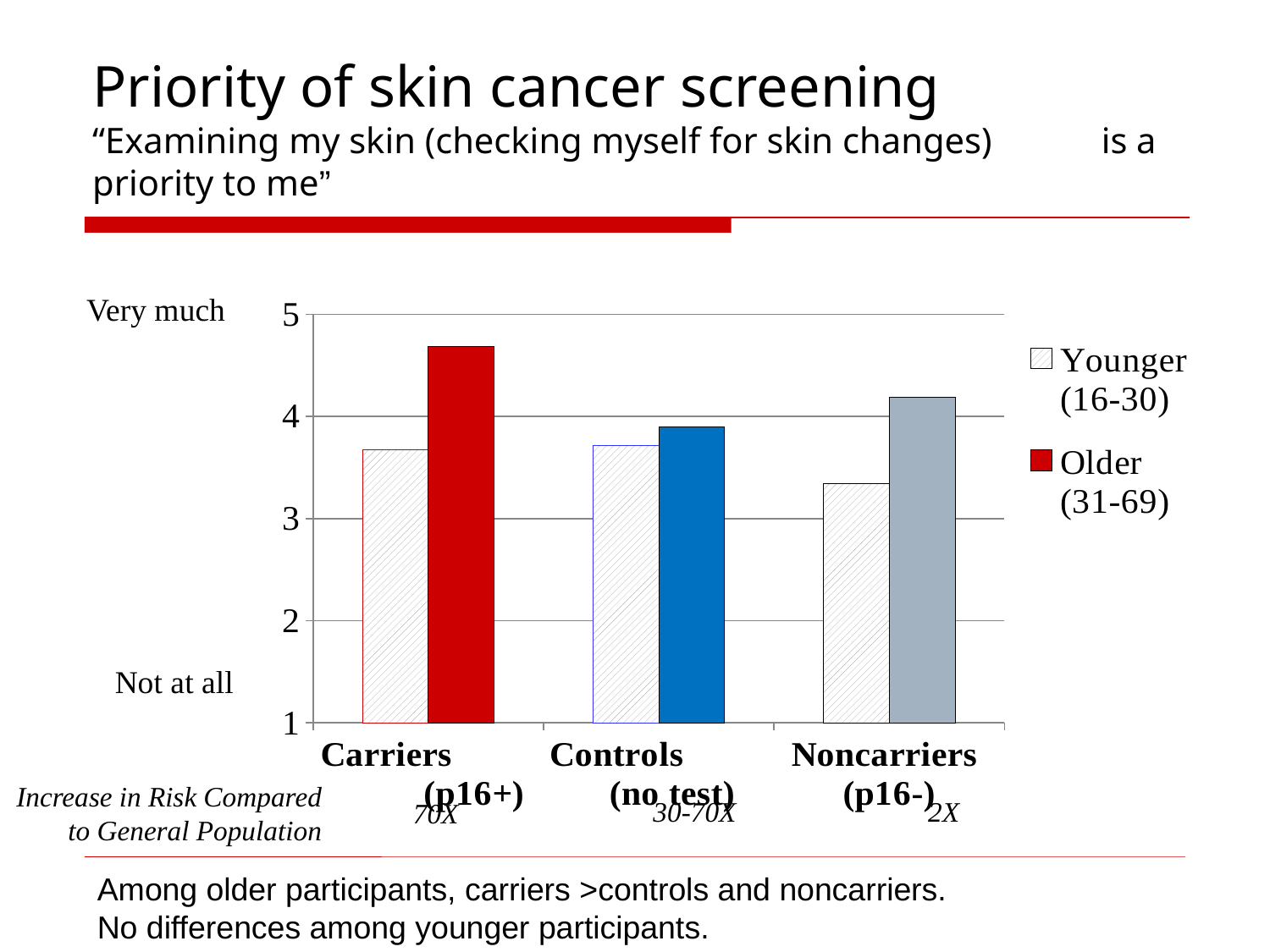
Is the Older (31-69) value for Carriers (p16+) greater or less than 4? greater For Carriers (p16+), which series has the larger value, Younger (16-30) or Older (31-69)? Older (31-69) How many series does the chart's legend list? 2 Is the Younger (16-30) value for Controls (no test) greater or less than 3? greater How many categories are shown on the x axis of the chart? 3 For the Older (31-69) series, which is larger, Carriers (p16+) or Noncarriers (p16-)? Carriers (p16+) Which category has the lowest value for the Younger (16-30) series? Noncarriers (p16-) What kind of chart is shown on the slide? bar chart Which category has the highest value for the Older (31-69) series? Carriers (p16+) Is the Younger (16-30) value for Noncarriers (p16-) greater or less than 4? less What are the two series listed in the chart's legend? Younger (16-30) and Older (31-69) What label appears at the top of the y axis, next to the value 5? Very much